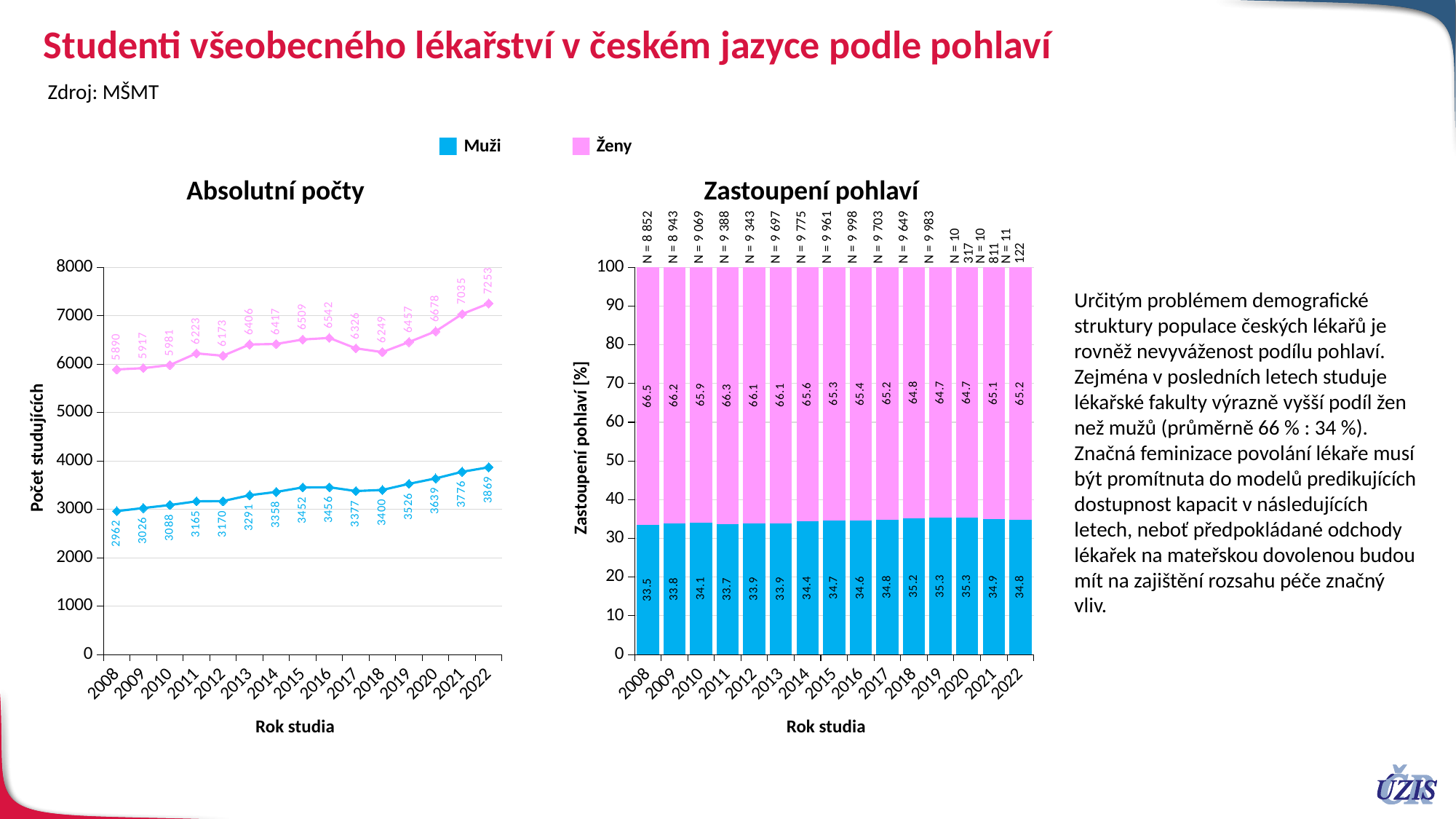
In the 'Absolutní počty' chart, what is the value for Muži in 2008? 2962 What kind of chart is 'Zastoupení pohlaví'? stacked bar chart In the 'Absolutní počty' chart, is the Ženy value for 2016 larger or smaller than the Ženy value for 2017? larger In the 'Absolutní počty' chart, what is the difference between the Ženy and Muži values in 2022? 3384 In the 'Zastoupení pohlaví' chart, what is the Muži percentage for 2019? 35.3 In the 'Absolutní počty' chart, what is the value for Ženy in 2022? 7253 How many series does the legend list? 2 In the 'Absolutní počty' chart, which year has the lowest value for Ženy? 2008 In the 'Absolutní počty' chart, which year has the highest value for Muži? 2022 In the 'Zastoupení pohlaví' chart, what is the Ženy percentage for 2008? 66.5 What kind of chart is 'Absolutní počty'? line chart In the 'Absolutní počty' chart, how many years are plotted on the x axis? 15